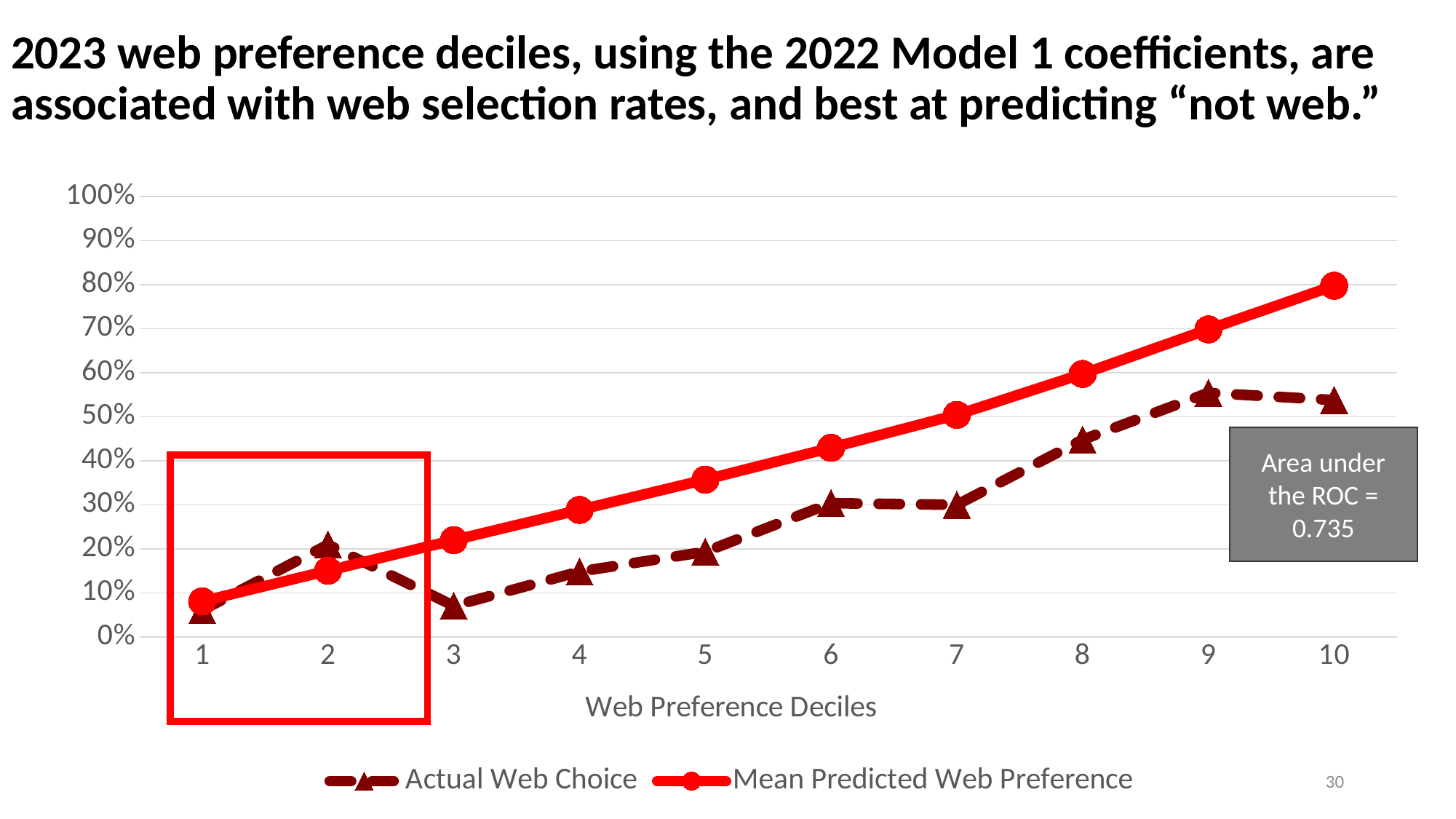
Is the Actual Web Choice value at decile 10 greater or less than 60%? less How many deciles are plotted along the x axis? 10 Is the Actual Web Choice value at decile 3 greater or less than 10%? less Is the Mean Predicted Web Preference value at decile 6 greater or less than 40%? greater At which decile is Mean Predicted Web Preference highest? 10 Does Mean Predicted Web Preference rise or fall as the deciles increase from 1 to 10? rise What kind of chart is shown on the slide? line chart At which decile is Mean Predicted Web Preference lowest? 1 What is the area under the ROC stated in the box on the chart? 0.735 How many series does the legend list? 2 At decile 8, which series has the higher value, Actual Web Choice or Mean Predicted Web Preference? Mean Predicted Web Preference